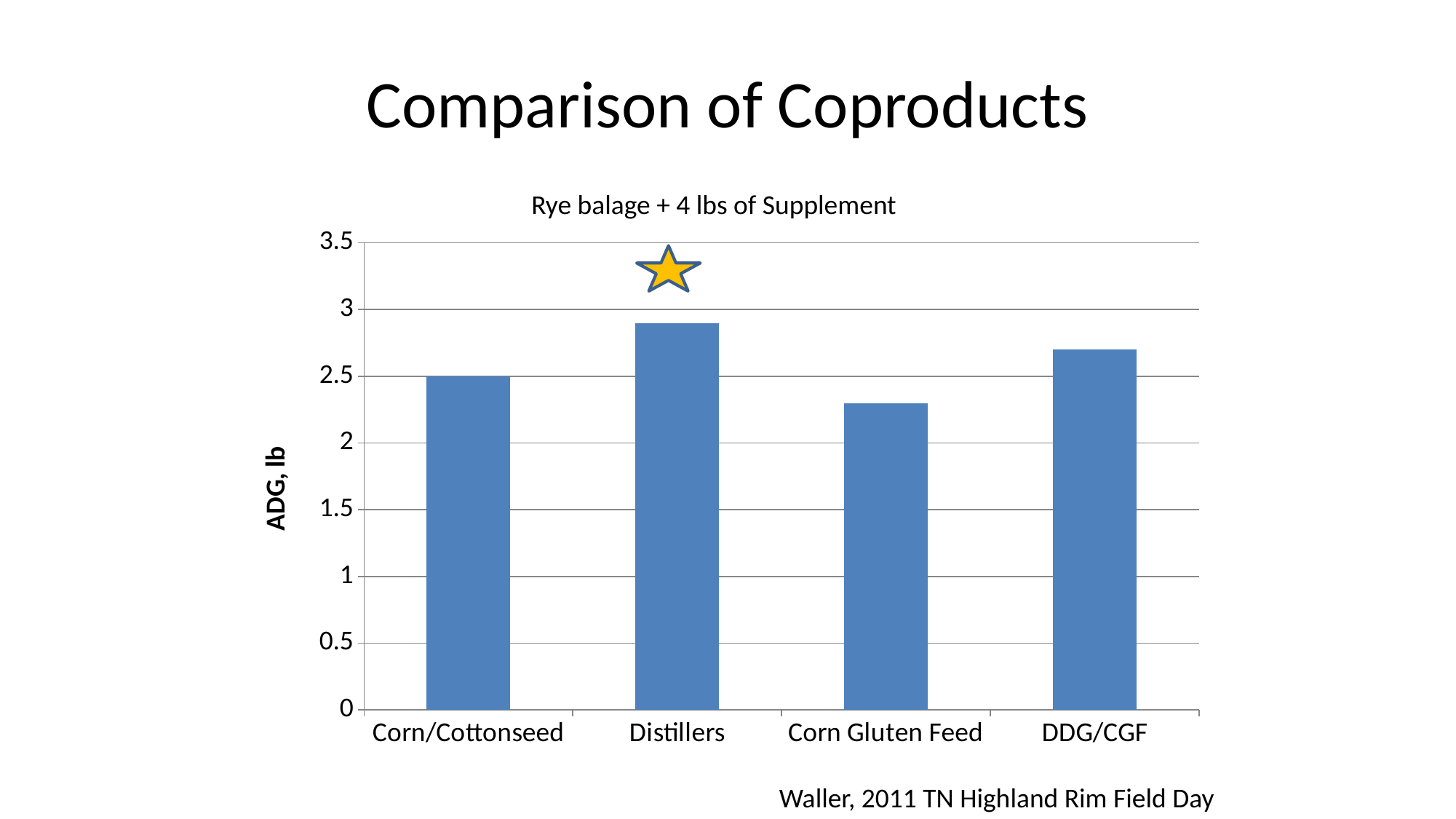
Which supplement has the lowest ADG? Corn Gluten Feed What type of chart is shown on the slide? Bar chart Which has a higher ADG, Corn/Cottonseed or Corn Gluten Feed? Corn/Cottonseed Which supplement has the highest ADG? Distillers What is the label on the vertical axis of the chart? ADG, lb What is the title of the chart? Rye balage + 4 lbs of Supplement Is the ADG value for DDG/CGF greater or less than 3? less How many supplement categories are plotted on the chart? 4 Is the ADG value for Corn Gluten Feed greater or less than 2.5? less Is the ADG value for Distillers greater or less than 2.5? greater Which has a higher ADG, Distillers or DDG/CGF? Distillers What is the ADG value for Corn/Cottonseed? 2.5